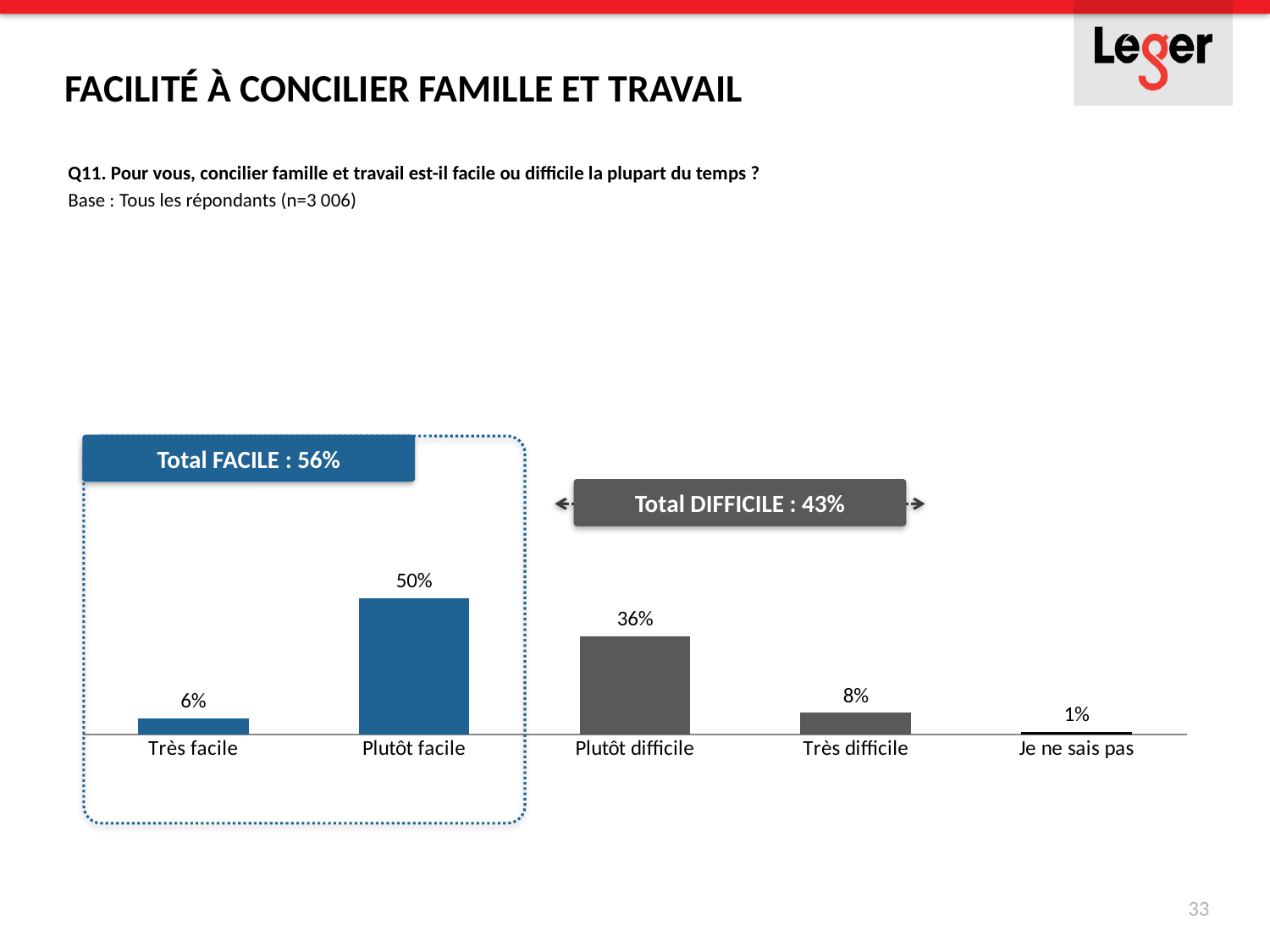
Which is larger, Très facile or Très difficile? Très difficile What kind of chart is this? Bar chart What is the Total DIFFICILE shown on the slide? 43% What is the difference between Plutôt facile and Plutôt difficile? 14% What is the value for Je ne sais pas? 1% What is the value for Plutôt facile? 50% Which category has the lowest value? Je ne sais pas Which category has the highest value? Plutôt facile What is the Total FACILE shown on the slide? 56% What is the value for Très difficile? 8% How many categories are shown on the x axis? 5 What is the value for Très facile? 6%